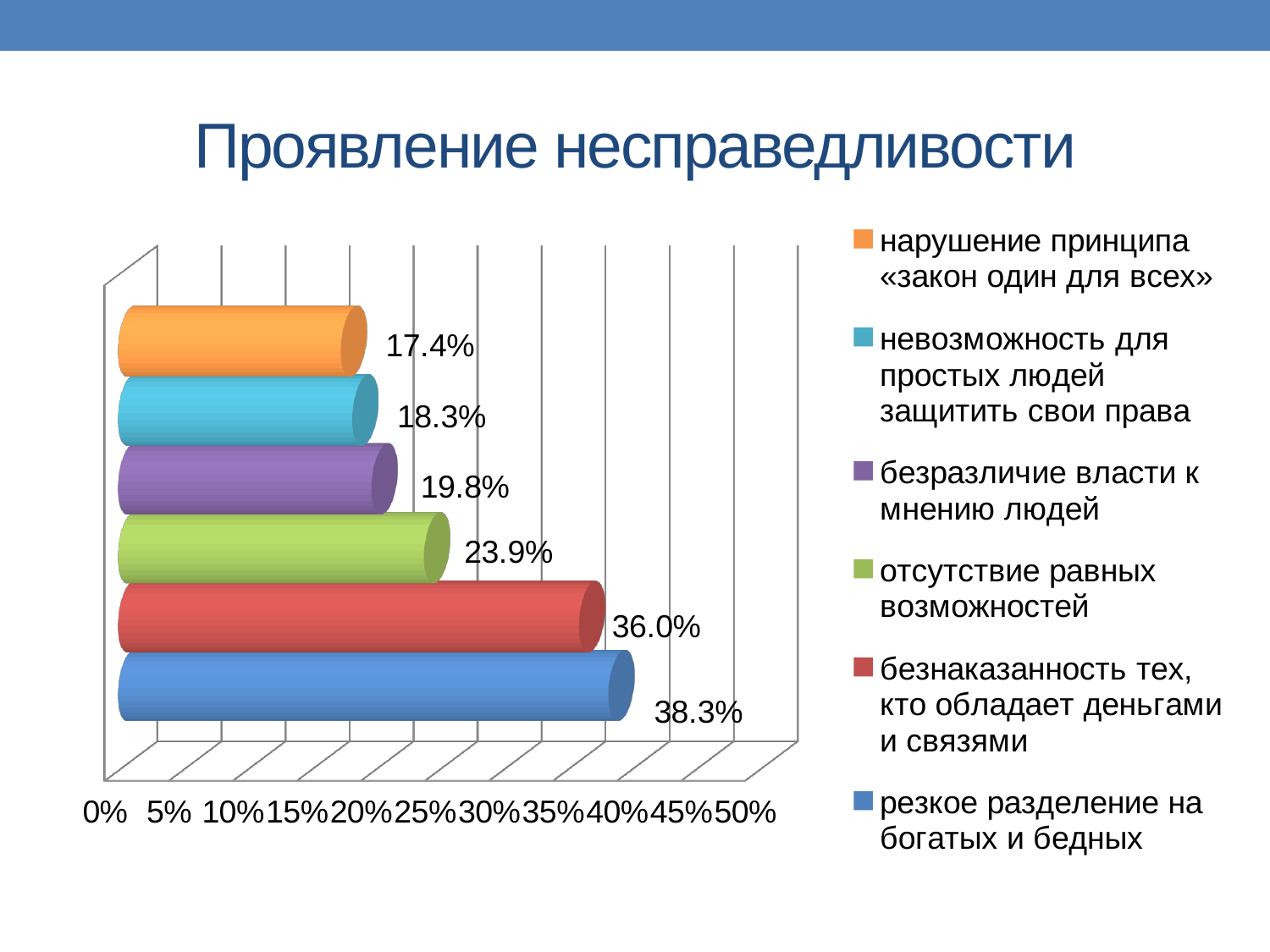
What is the value for «резкое разделение на богатых и бедных»? 38.3% How many entries does the legend list? 6 Which category has the lowest value? нарушение принципа «закон один для всех» Which category has the highest value? резкое разделение на богатых и бедных What is the value for «отсутствие равных возможностей»? 23.9% What is the difference between the values for «резкое разделение на богатых и бедных» and «безнаказанность тех, кто обладает деньгами и связями»? 2.3% What is the title of the slide? Проявление несправедливости What is the value for «нарушение принципа «закон один для всех»»? 17.4% How many bars are plotted on the chart? 6 What kind of chart is shown on the slide? bar chart What is the value for «безнаказанность тех, кто обладает деньгами и связями»? 36.0% Which is larger: the value for «безразличие власти к мнению людей» or the value for «отсутствие равных возможностей»? отсутствие равных возможностей